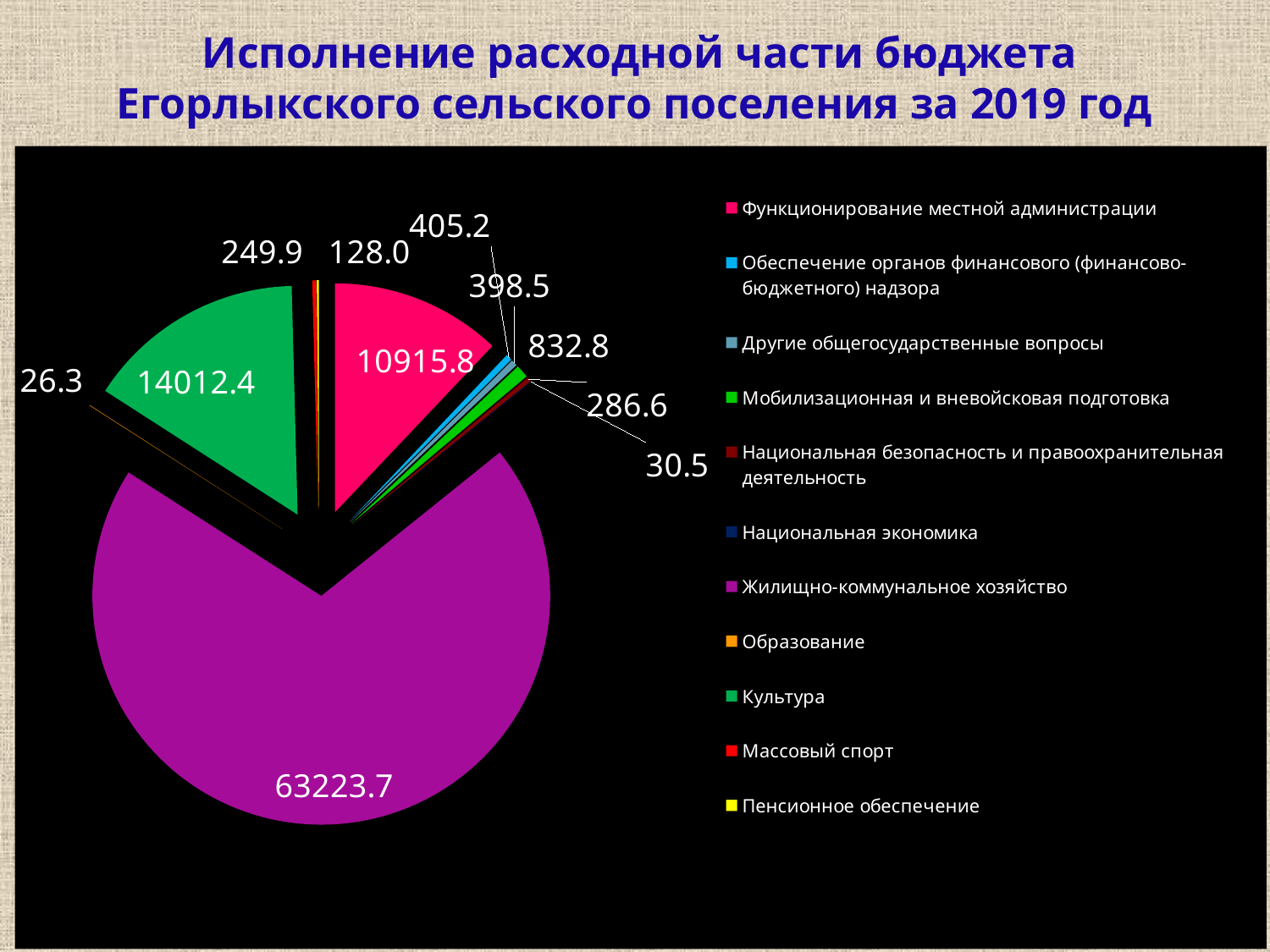
What is the value shown for Культура? 14012.4 What colour is the slice for Жилищно-коммунальное хозяйство? purple Which is larger: the value for Культура or the value for Функционирование местной администрации? Культура What is the title of the slide containing the pie chart? Исполнение расходной части бюджета Егорлыкского сельского поселения за 2019 год What is the smallest value printed on the pie chart? 26.3 Which category has the largest slice in the pie chart? Жилищно-коммунальное хозяйство What is the value shown for Жилищно-коммунальное хозяйство? 63223.7 How many categories does the legend of the pie chart list? 11 What is the value shown for Функционирование местной администрации? 10915.8 What is the difference between the value for Культура and the value for Функционирование местной администрации? 3096.6 What is the difference between the value for Жилищно-коммунальное хозяйство and the value for Культура? 49211.3 What kind of chart is shown on the slide? pie chart